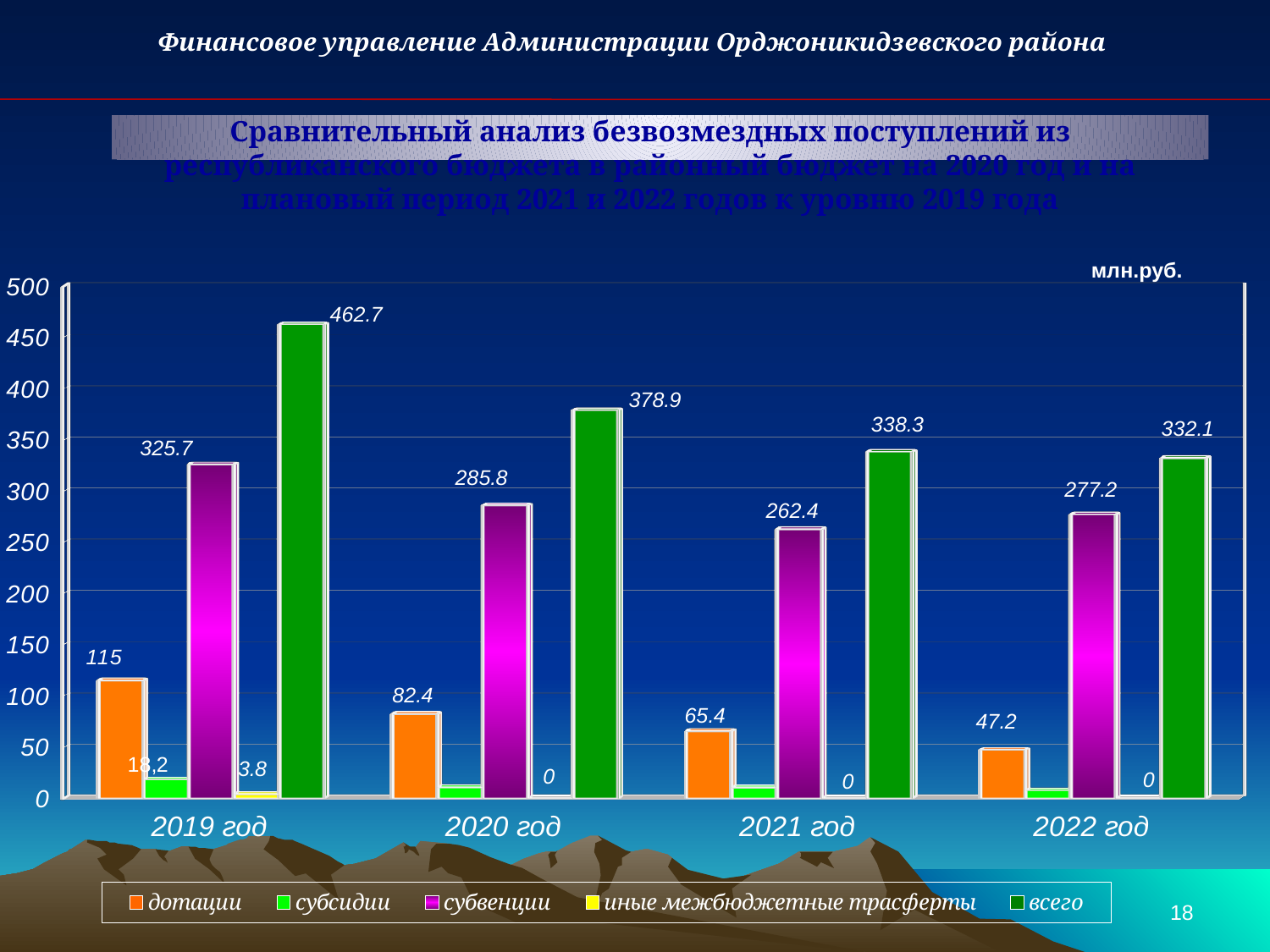
What is the value of дотации for 2022 год? 47.2 How many series does the legend list? 5 Which year has the lowest value for дотации? 2022 год What is the value of субвенции for 2021 год? 262.4 Do the values for дотации rise or fall from 2019 год to 2022 год? fall What is the value of иные межбюджетные трасферты for 2020 год? 0 Which year has the highest value for всего? 2019 год How many year categories are shown on the x axis? 4 What kind of chart is shown on the slide? bar chart Which is larger: субвенции for 2021 год or субвенции for 2022 год? 2022 год What is the value of всего for 2019 год? 462.7 What is the difference between всего for 2019 год and всего for 2020 год? 83.8